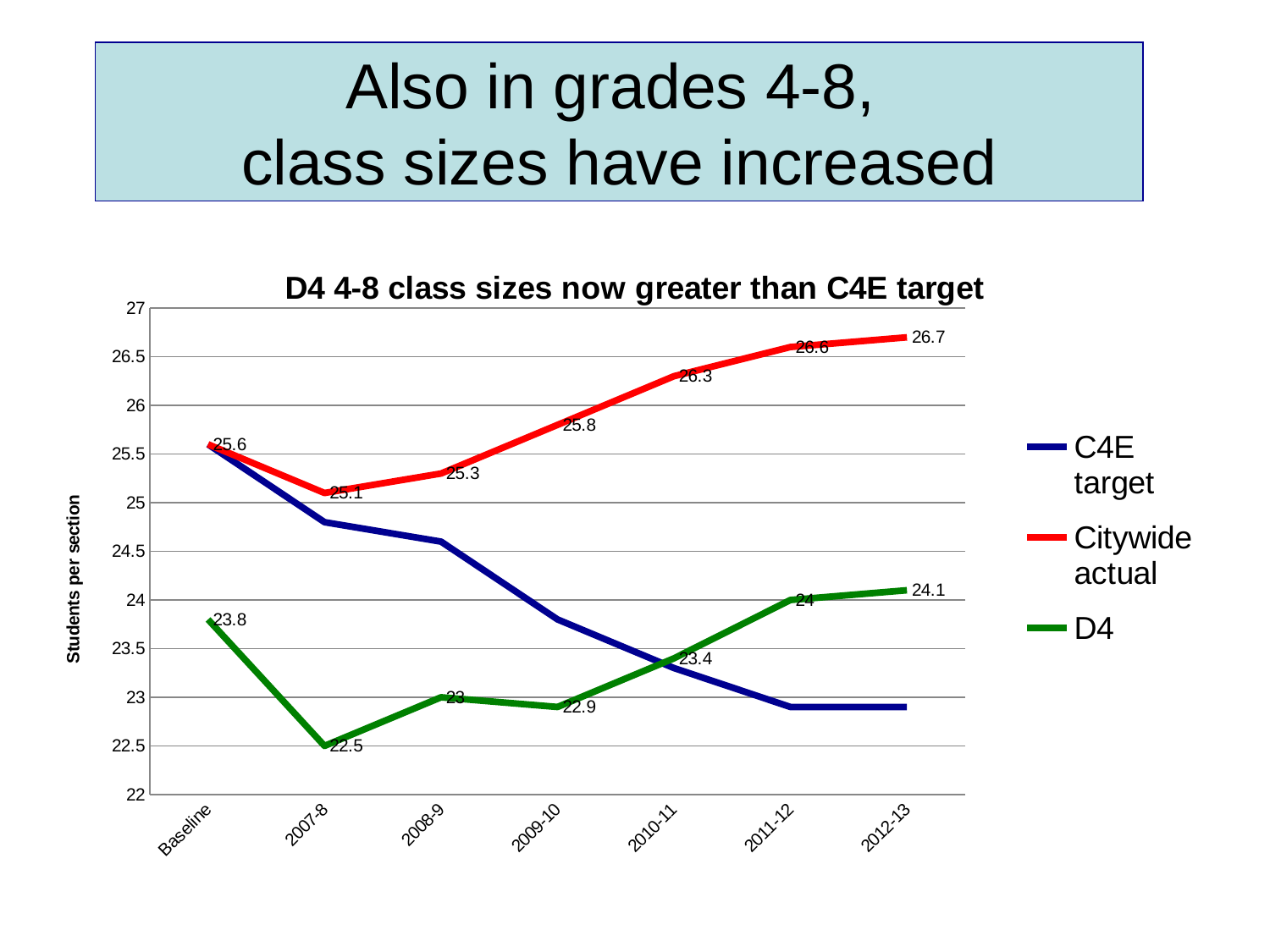
How many points are plotted along the x axis for each series? 7 What is the title of the y axis? Students per section In which year is the Citywide actual value highest? 2012-13 Is the C4E target value for 2007-8 greater or less than 24.5? greater What kind of chart is shown on the slide? line chart What is the Citywide actual value for 2012-13? 26.7 Which is larger for D4: the value in 2010-11 or the value in 2011-12? 2011-12 Does the C4E target line rise or fall from Baseline to 2012-13? fall How many series does the legend list? 3 In which year is the D4 value lowest? 2007-8 By how much did the Citywide actual value increase from Baseline to 2012-13? 1.1 What is the D4 value for 2007-8? 22.5